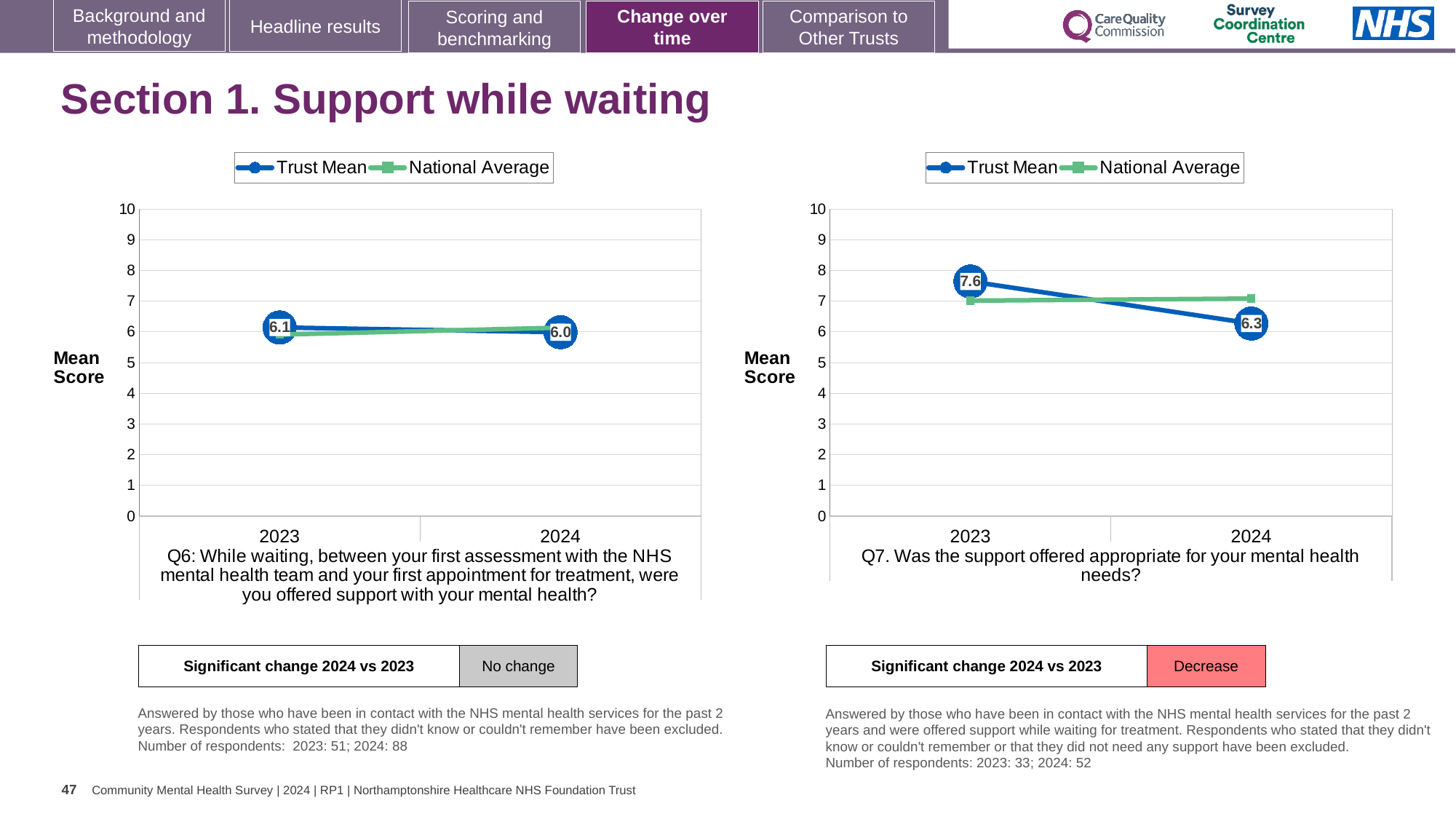
In the Q7 chart on the right, does the Trust Mean rise or fall from 2023 to 2024? fall In the Q7 chart on the right, is the National Average for 2023 greater or less than 8? less In the Q6 chart on the left, what is the Trust Mean for 2023? 6.1 In the Q7 chart on the right, which is larger in 2024, the Trust Mean or the National Average? National Average What kind of chart is the Q6 chart on the left? line chart In the Q7 chart on the right, what is the Trust Mean for 2024? 6.3 In the Q7 chart on the right, by how much did the Trust Mean fall from 2023 to 2024? 1.3 How many years are shown on the x axis of the Q6 chart on the left? 2 In the Q7 chart on the right, what is the Trust Mean for 2023? 7.6 In the Q6 chart on the left, what is the Trust Mean for 2024? 6.0 In the Q7 chart on the right, which is larger in 2023, the Trust Mean or the National Average? Trust Mean How many series does the legend of the Q7 chart on the right list? 2